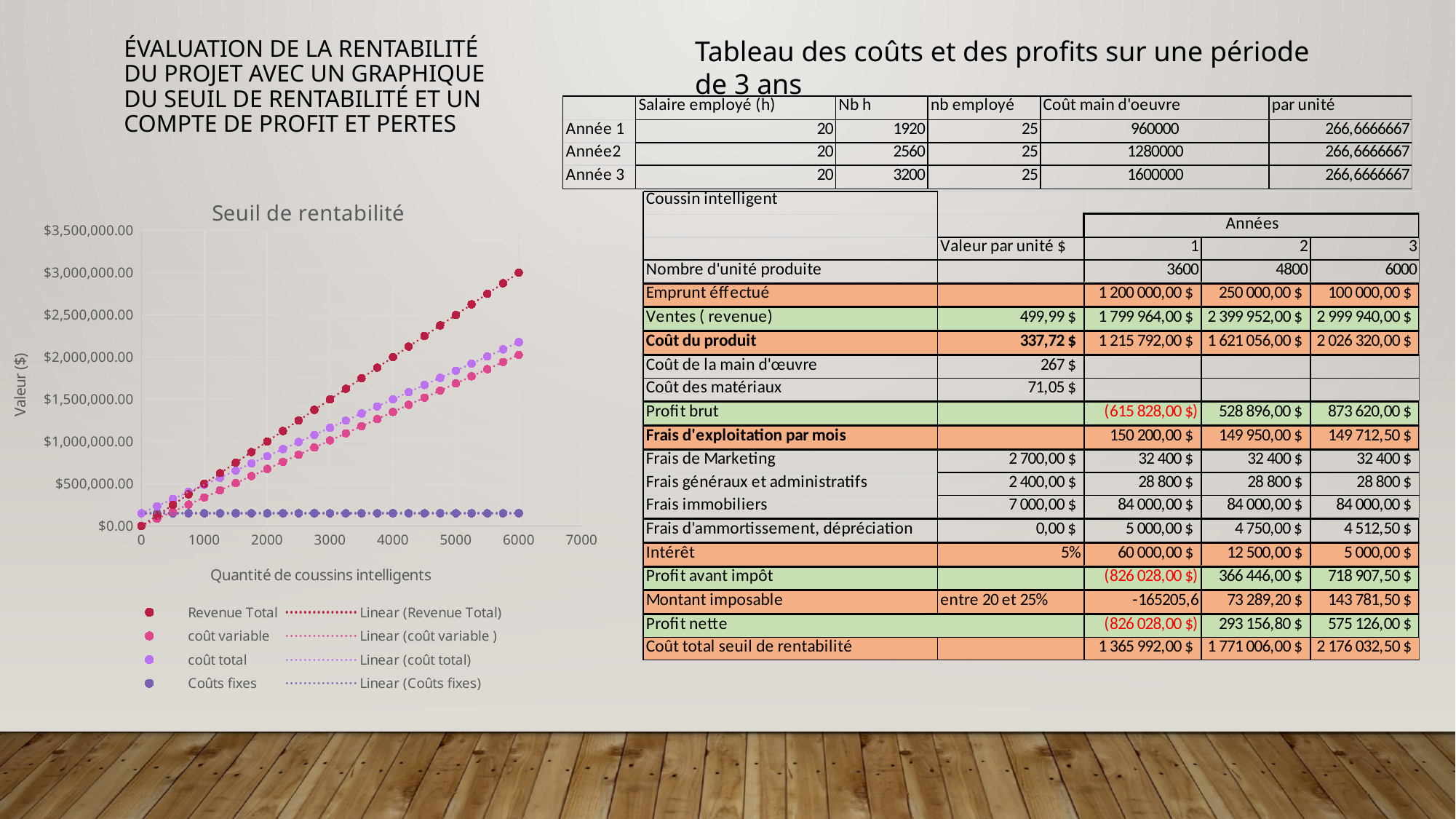
In the 'Seuil de rentabilité' chart, at a quantity of 6000, which is larger: coût total or coût variable? coût total What is the title of the chart on the slide? Seuil de rentabilité In the 'Seuil de rentabilité' chart, is the Coûts fixes value at a quantity of 6000 greater or less than $500,000.00? less In the 'Seuil de rentabilité' chart, does the Coûts fixes series rise, fall or stay flat as the quantity increases? stay flat In the 'Seuil de rentabilité' chart, is the coût variable value at a quantity of 6000 greater or less than $2,500,000.00? less In the 'Seuil de rentabilité' chart, which series has the lowest value at a quantity of 6000? Coûts fixes How many entries does the legend of the 'Seuil de rentabilité' chart list? 8 In the 'Seuil de rentabilité' chart, which series has the highest value at a quantity of 6000? Revenue Total What kind of chart is the 'Seuil de rentabilité' chart? scatter chart In the 'Seuil de rentabilité' chart, is the Revenue Total value at a quantity of 6000 greater or less than $2,500,000.00? greater In the 'Seuil de rentabilité' chart, does the Revenue Total series rise or fall as the quantity increases? rise What is the label of the x axis of the 'Seuil de rentabilité' chart? Quantité de coussins intelligents